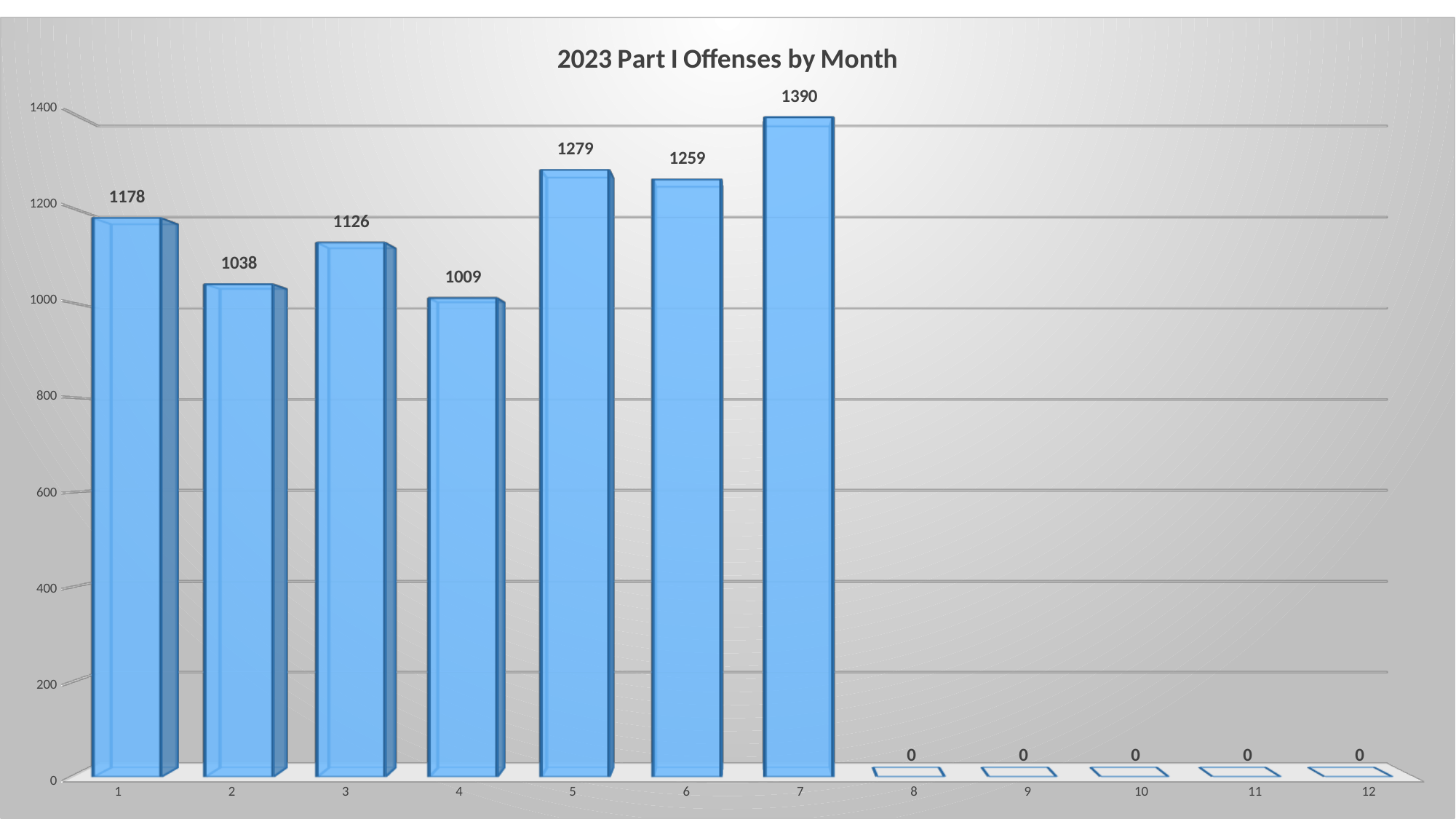
What is the value for month 5? 1279 What is the title of the chart? 2023 Part I Offenses by Month What is the value for month 4? 1009 Which month has the highest value? 7 How many months are shown on the x axis? 12 Is the value for month 6 greater or less than 1200? greater What is the value for month 1? 1178 How many months show a value of 0? 5 What is the difference between the values for month 7 and month 6? 131 What kind of chart is this? bar chart Among months 1 through 7, which month has the lowest value? 4 Which is larger, the value for month 2 or the value for month 3? month 3